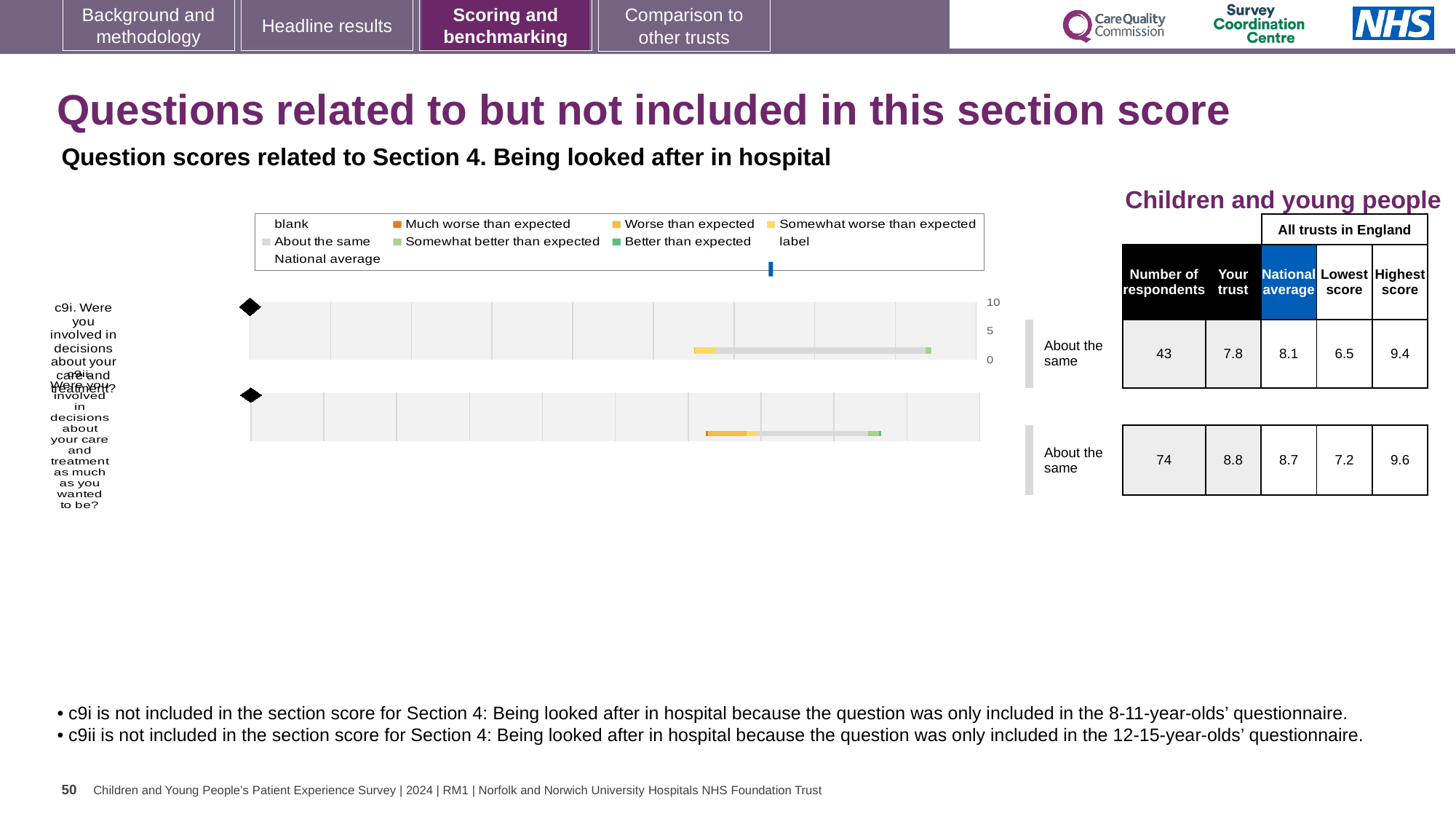
What is the national average score for question c9ii? 8.7 Which question has more respondents, c9i or c9ii? c9ii What kind of chart is used to show the question scores for c9i and c9ii? Bar chart Which question has the higher 'Your trust' score? c9ii What is the 'Your trust' score for question c9i? 7.8 How many questions are plotted in the chart? 2 What is the subtitle above the chart describing the question scores? Question scores related to Section 4. Being looked after in hospital What is the difference between the highest score and the lowest score for question c9i? 2.9 By how much does the 'Your trust' score for c9ii exceed its national average? 0.1 What benchmark category is shown for question c9i? About the same How many respondents answered question c9ii? 74 For question c9i, which is larger: the 'Your trust' score or the national average? National average